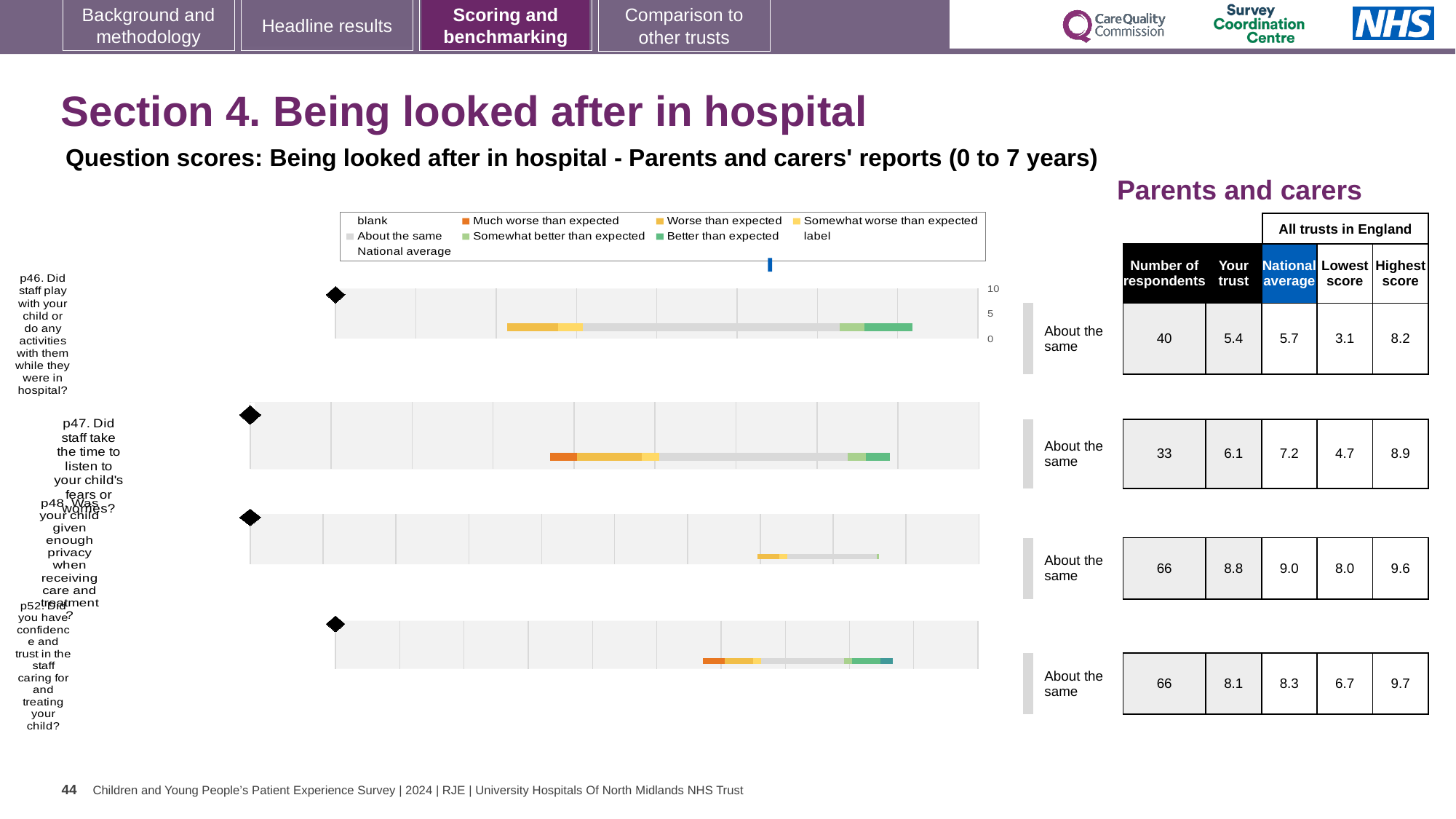
What is the maximum value shown on the score axis of the charts? 10 What benchmark rating is shown for all four questions on the slide? About the same Which question has the lowest number of respondents? p47 For p47, which is larger: the 'Your trust' score or the national average? National average What is the national average score for p47 (Did staff take the time to listen to your child's fears or worries?)? 7.2 Which question has the highest 'Your trust' score? p48 How many survey questions (bars) are plotted on the slide? 4 What is the highest score among all trusts in England for p52 (Did you have confidence and trust in the staff caring for and treating your child?)? 9.7 What kind of chart is used to show the question scores on this slide? bar chart For p46, what is the difference between the national average and the 'Your trust' score? 0.3 How many respondents answered p48 (Was your child given enough privacy when receiving care and treatment?)? 66 What is the 'Your trust' score for p46 (Did staff play with your child or do any activities with them while they were in hospital?)? 5.4